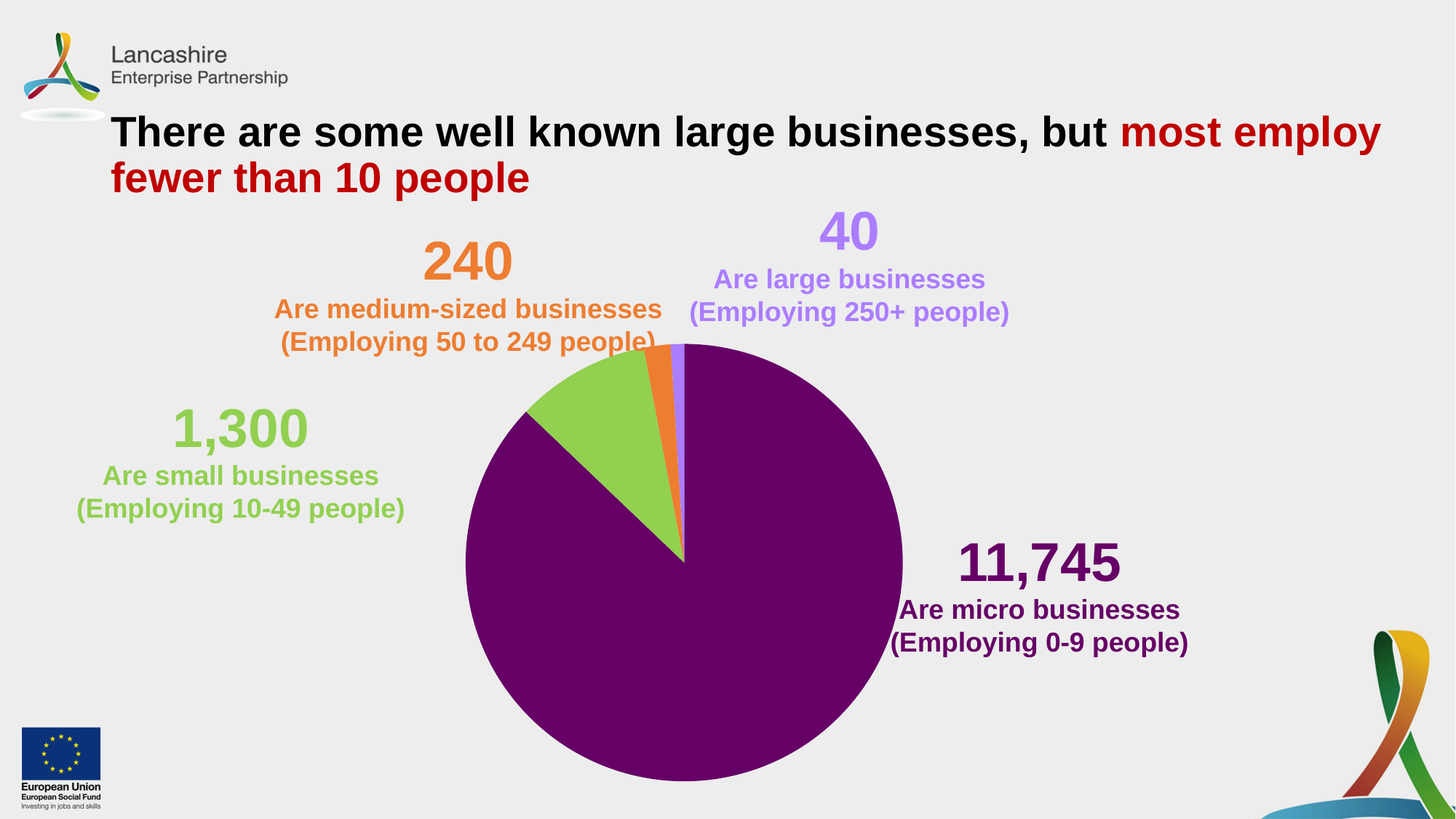
Which is larger: the number of small businesses or the number of medium-sized businesses? small businesses What type of chart is shown on the slide? pie chart How many medium-sized businesses (employing 50 to 249 people) are there? 240 How many slices does the pie chart have? 4 How many small businesses (employing 10-49 people) are there? 1,300 What is the difference between the number of medium-sized businesses and the number of large businesses? 200 How many micro businesses (employing 0-9 people) are there? 11,745 What is the difference between the number of micro businesses and the number of small businesses? 10,445 How many large businesses (employing 250+ people) are there? 40 What colour is the slice representing micro businesses? purple Which business size category has the largest slice of the pie? Micro businesses (Employing 0-9 people) Which business size category has the smallest slice of the pie? Large businesses (Employing 250+ people)